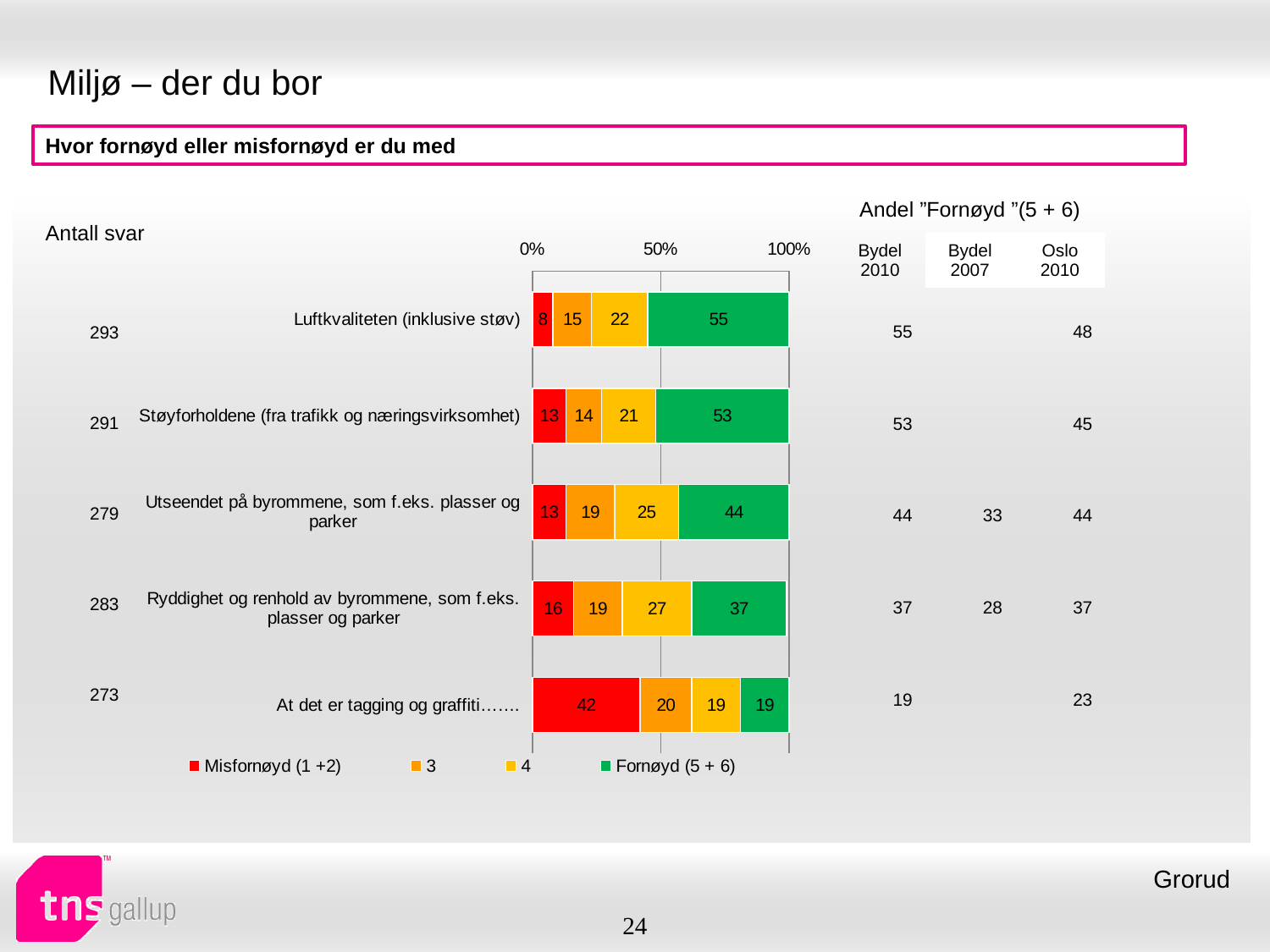
How many series does the chart legend list? 4 How many categories (questions) are plotted in the chart? 5 Which category has the lowest 'Fornøyd (5 + 6)' value? At det er tagging og graffiti… What colour represents the 'Fornøyd (5 + 6)' series in the chart? green What kind of chart is shown on the slide? stacked bar chart What is the total of the stacked bar for 'Utseendet på byrommene, som f.eks. plasser og parker'? 101 Which category has the highest 'Fornøyd (5 + 6)' value? Luftkvaliteten (inklusive støv) What is the 'Fornøyd (5 + 6)' value for 'Luftkvaliteten (inklusive støv)'? 55 What is the 'Misfornøyd (1 +2)' value for 'At det er tagging og graffiti…'? 42 What is the difference between the 'Fornøyd (5 + 6)' values for 'Luftkvaliteten (inklusive støv)' and 'Ryddighet og renhold av byrommene, som f.eks. plasser og parker'? 18 What is the value of series '4' for 'Ryddighet og renhold av byrommene, som f.eks. plasser og parker'? 27 Which is larger: the 'Misfornøyd (1 +2)' value for 'Støyforholdene (fra trafikk og næringsvirksomhet)' or for 'Ryddighet og renhold av byrommene, som f.eks. plasser og parker'? Ryddighet og renhold av byrommene, som f.eks. plasser og parker